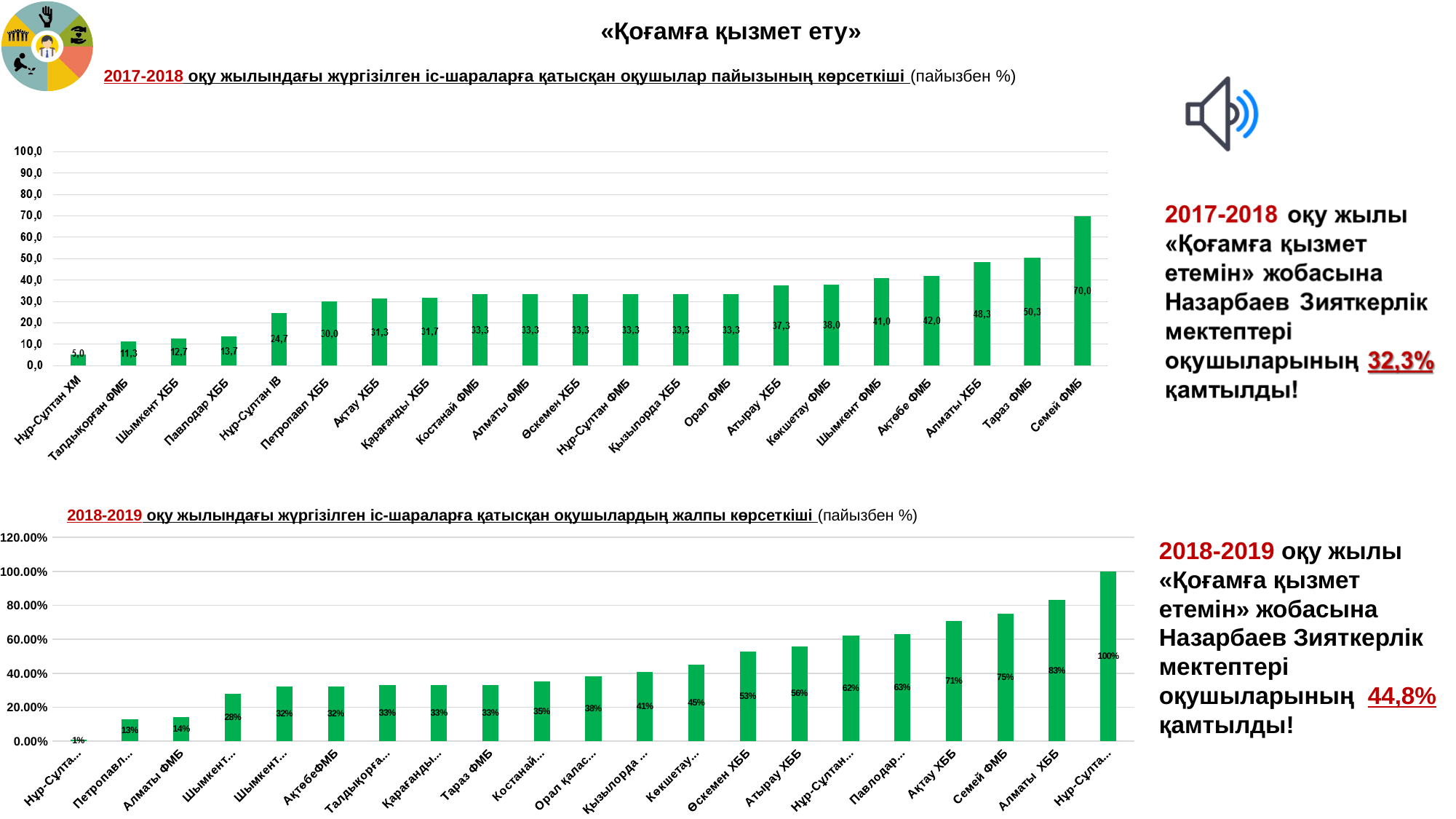
In the 2018-2019 chart, what is the value for Ақтау ХББ? 71% In the 2017-2018 chart, which is larger: Ақтөбе ФМБ or Шымкент ФМБ? Ақтөбе ФМБ In the 2017-2018 chart, what is the value for Тараз ФМБ? 50,3 In the 2018-2019 chart, what is the value for Семей ФМБ? 75% In the 2017-2018 chart, which category has the highest value? Семей ФМБ In the 2018-2019 chart, what is the difference between Алматы ХББ and Өскемен ХББ? 30% How many bars are in the 2017-2018 chart? 21 In the 2018-2019 chart, do the values rise or fall from left to right? Rise In the 2017-2018 chart, which category has the lowest value? Нұр-Сұлтан ХМ What type of chart is the 2018-2019 chart? Bar chart In the 2017-2018 chart, what is the value for Семей ФМБ? 70,0 In the 2017-2018 chart, what is the difference between Семей ФМБ and Тараз ФМБ? 19,7